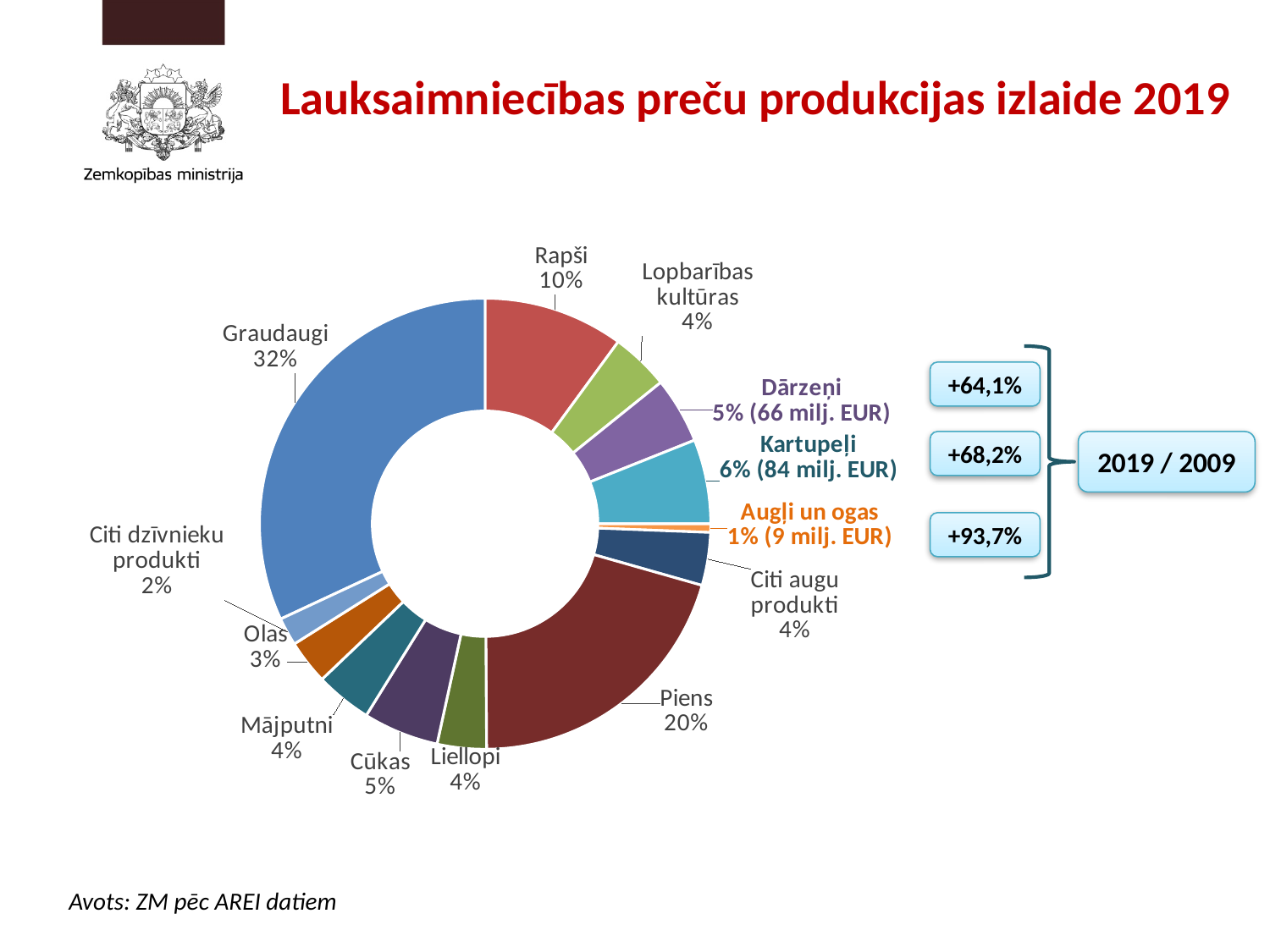
What is the title of the slide? Lauksaimniecības preču produkcijas izlaide 2019 What value is shown for Dārzeņi? 5% (66 milj. EUR) What value is shown for Kartupeļi? 6% (84 milj. EUR) How many categories are shown in the chart? 13 What value is shown for Augļi un ogas? 1% (9 milj. EUR) Which has a larger share, Rapši or Cūkas? Rapši What share of the chart does Piens have? 20% What share of the chart does Graudaugi have? 32% Which category has the smallest share of the chart? Augļi un ogas What kind of chart is shown on the slide? Doughnut (pie) chart What is the difference in percentage points between Graudaugi and Piens? 12 percentage points Which category has the largest share of the chart? Graudaugi